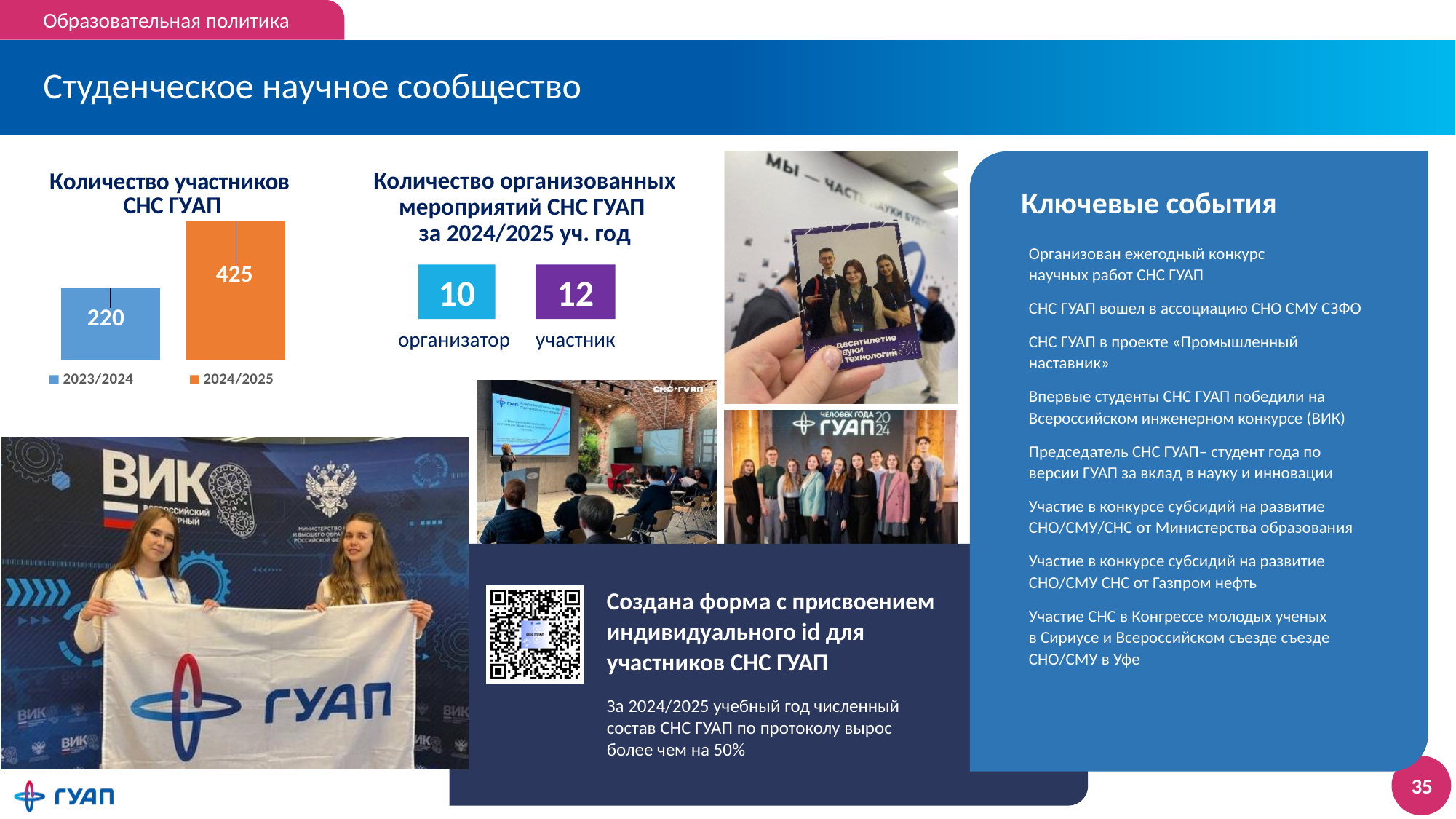
In the chart 'Количество участников СНС ГУАП', do the values rise or fall from 2023/2024 to 2024/2025? Rise In the chart 'Количество участников СНС ГУАП', what is the difference between the 2024/2025 and 2023/2024 values? 205 What kind of chart is 'Количество участников СНС ГУАП'? Bar chart How many bars are plotted in the chart 'Количество участников СНС ГУАП'? 2 In the chart 'Количество участников СНС ГУАП', what colour is the bar for 2024/2025? Orange What is the title of the bar chart on the left of the slide? Количество участников СНС ГУАП How many entries does the legend of the chart 'Количество участников СНС ГУАП' list? 2 In the chart 'Количество участников СНС ГУАП', which year has the highest value? 2024/2025 In the chart 'Количество участников СНС ГУАП', which is larger: the value for 2023/2024 or for 2024/2025? 2024/2025 In the chart 'Количество участников СНС ГУАП', what is the value for 2023/2024? 220 In the chart 'Количество участников СНС ГУАП', what is the value for 2024/2025? 425 In the chart 'Количество участников СНС ГУАП', which year has the lowest value? 2023/2024